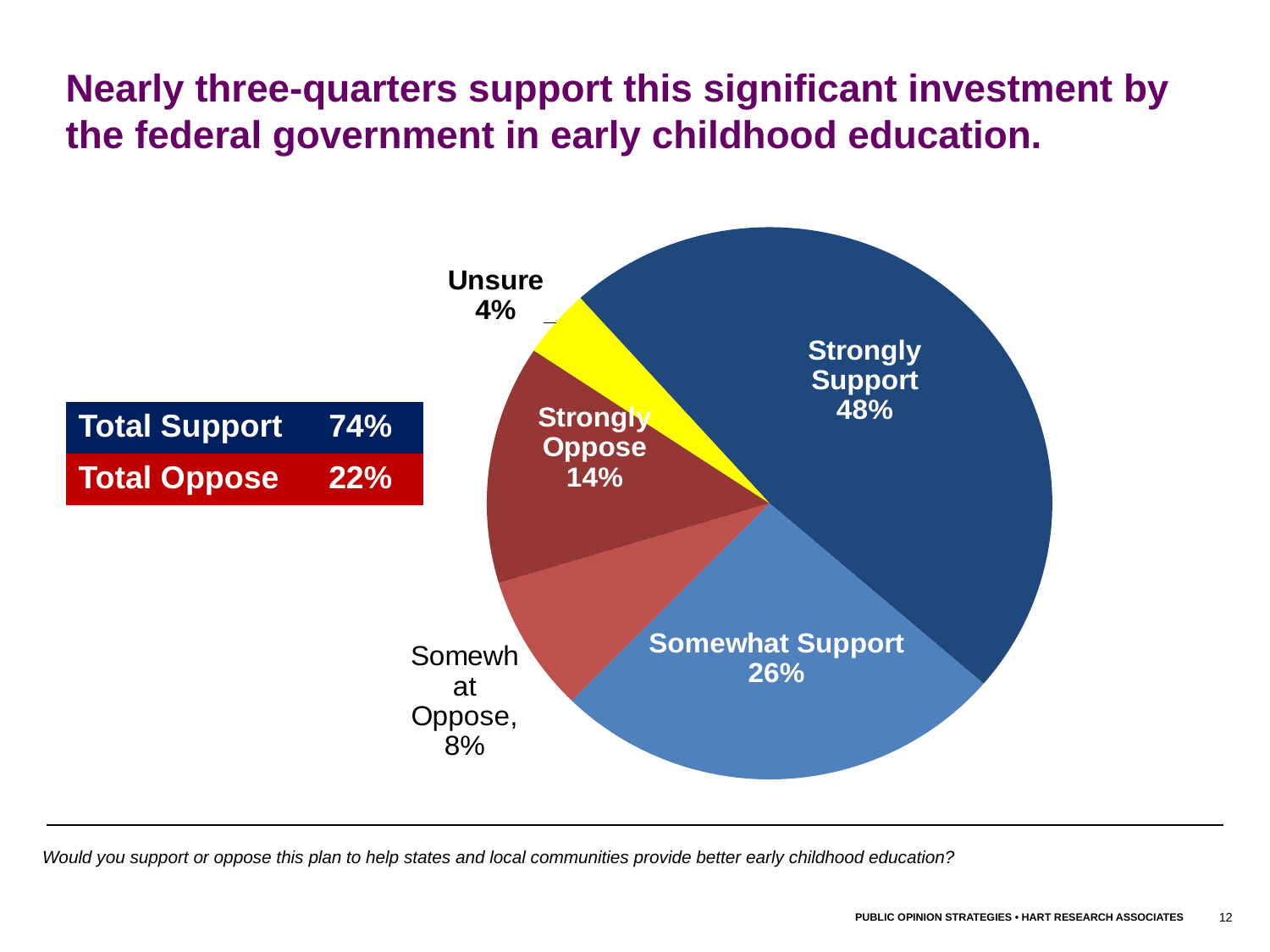
What kind of chart is shown on the slide? Pie chart What is the difference between the Strongly Support and Strongly Oppose percentages? 34 percentage points What percentage of respondents somewhat oppose the plan? 8% Which is larger, Somewhat Support or Somewhat Oppose? Somewhat Support What percentage of respondents strongly support the plan? 48% What is the Total Support percentage shown in the box to the left of the pie chart? 74% What percentage of respondents somewhat support the plan? 26% Which slice of the pie chart is the largest? Strongly Support What percentage of respondents are unsure? 4% What percentage of respondents strongly oppose the plan? 14% How many slices does the pie chart have? 5 Which slice of the pie chart is the smallest? Unsure